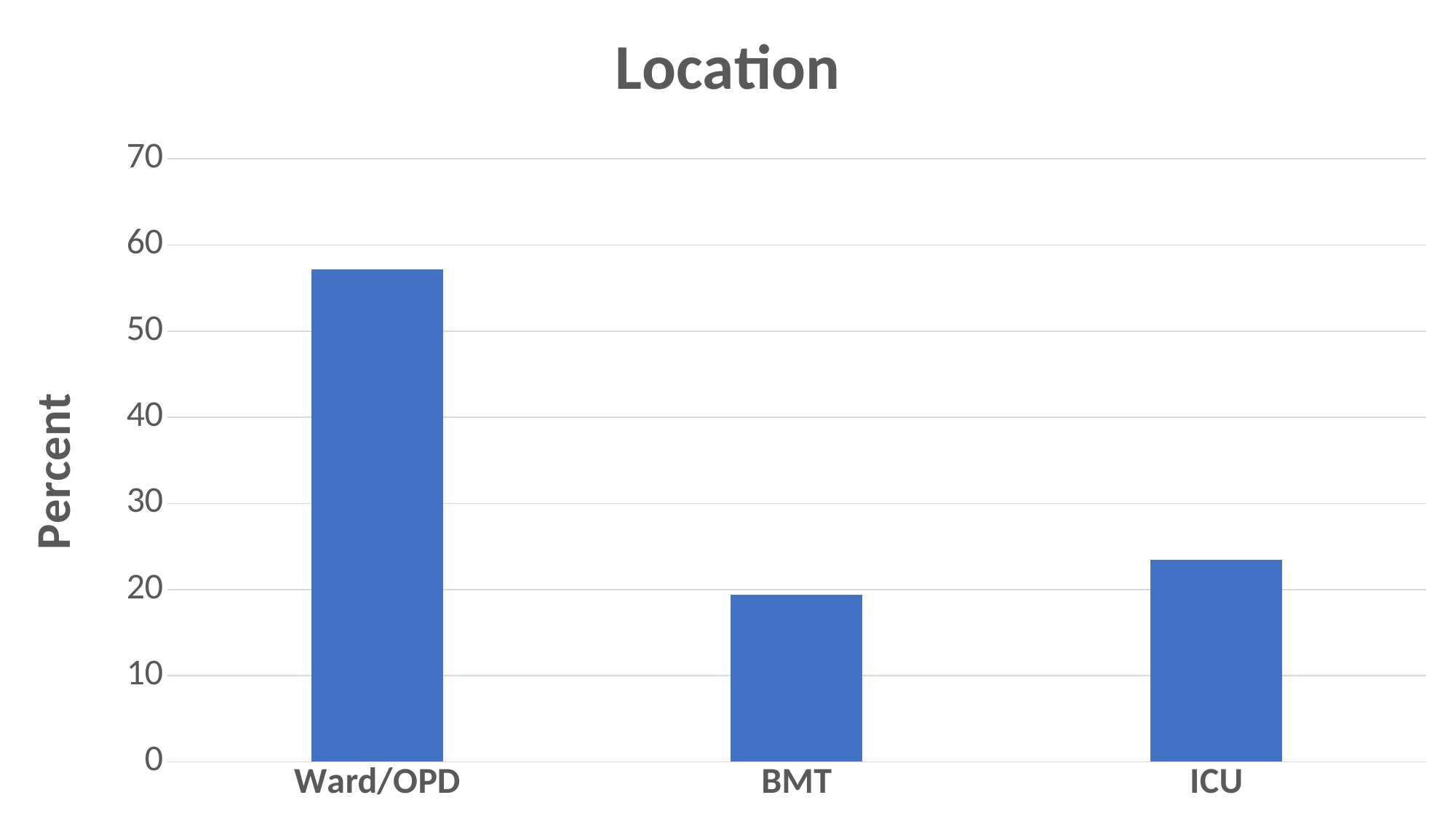
Which location has the highest percent? Ward/OPD Which has a larger percent, Ward/OPD or ICU? Ward/OPD How many categories are shown on the x axis of the chart? 3 What type of chart is shown on the slide? bar chart Is the value for BMT greater or less than 10? greater Is the value for ICU greater or less than 30? less What is the title of the chart? Location What is the label on the vertical axis of the chart? Percent Which location has the lowest percent? BMT Is the value for Ward/OPD greater or less than 60? less Which has a larger percent, ICU or BMT? ICU